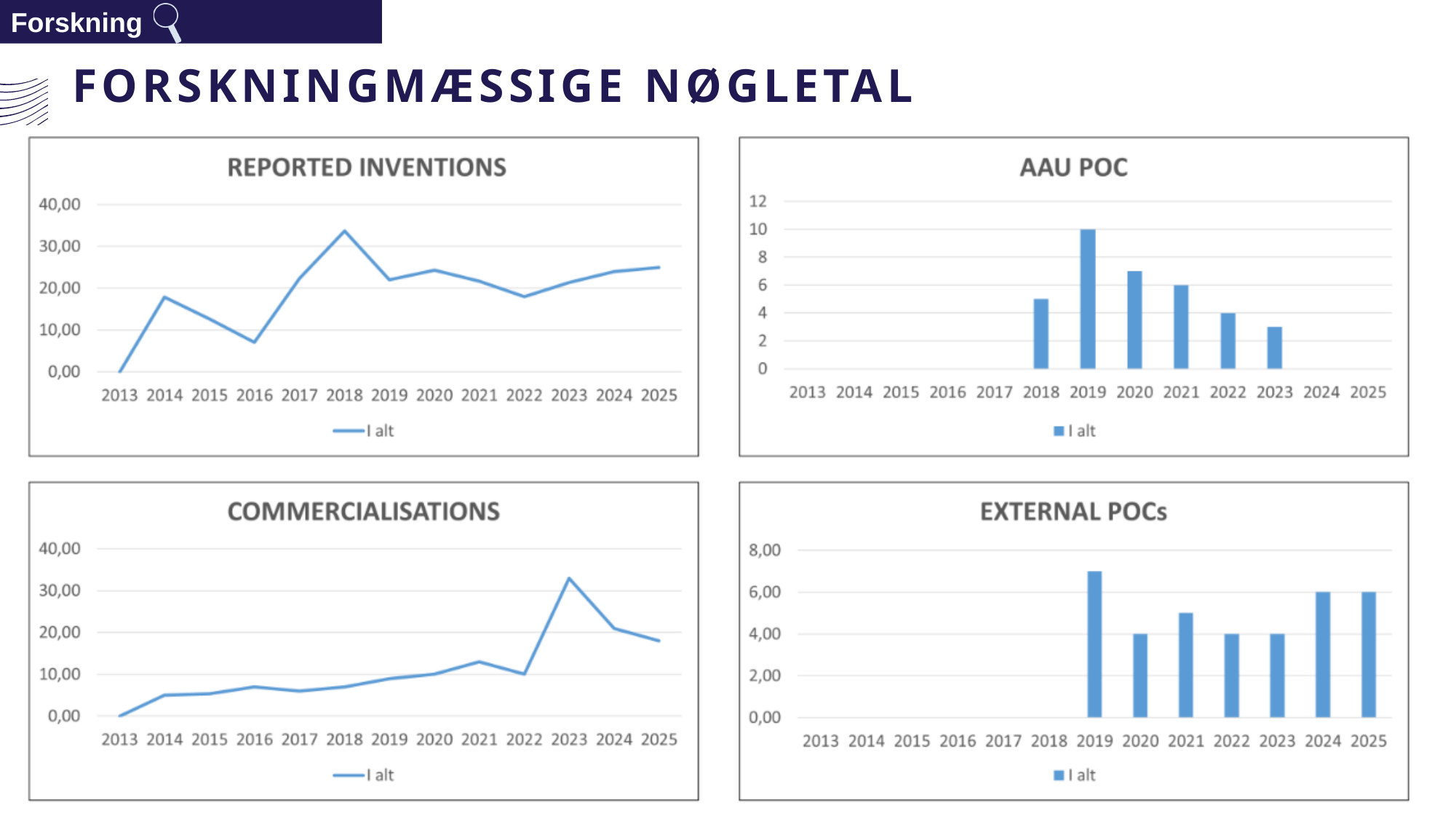
How many series does the legend of the EXTERNAL POCs chart list? 1 In the COMMERCIALISATIONS chart, is the value for 2022 greater or less than 20,00? less What kind of chart is the AAU POC chart? bar chart In the REPORTED INVENTIONS chart, is the value for 2018 greater or less than 30,00? greater In the AAU POC chart, what is the value for 2022? 4 In the EXTERNAL POCs chart, what is the value for 2024? 6,00 In the AAU POC chart, what is the value for 2019? 10 What kind of chart is the REPORTED INVENTIONS chart? line chart In the AAU POC chart, which year has the highest value? 2019 In the COMMERCIALISATIONS chart, which year has the highest value? 2023 In the EXTERNAL POCs chart, which year has the highest value? 2019